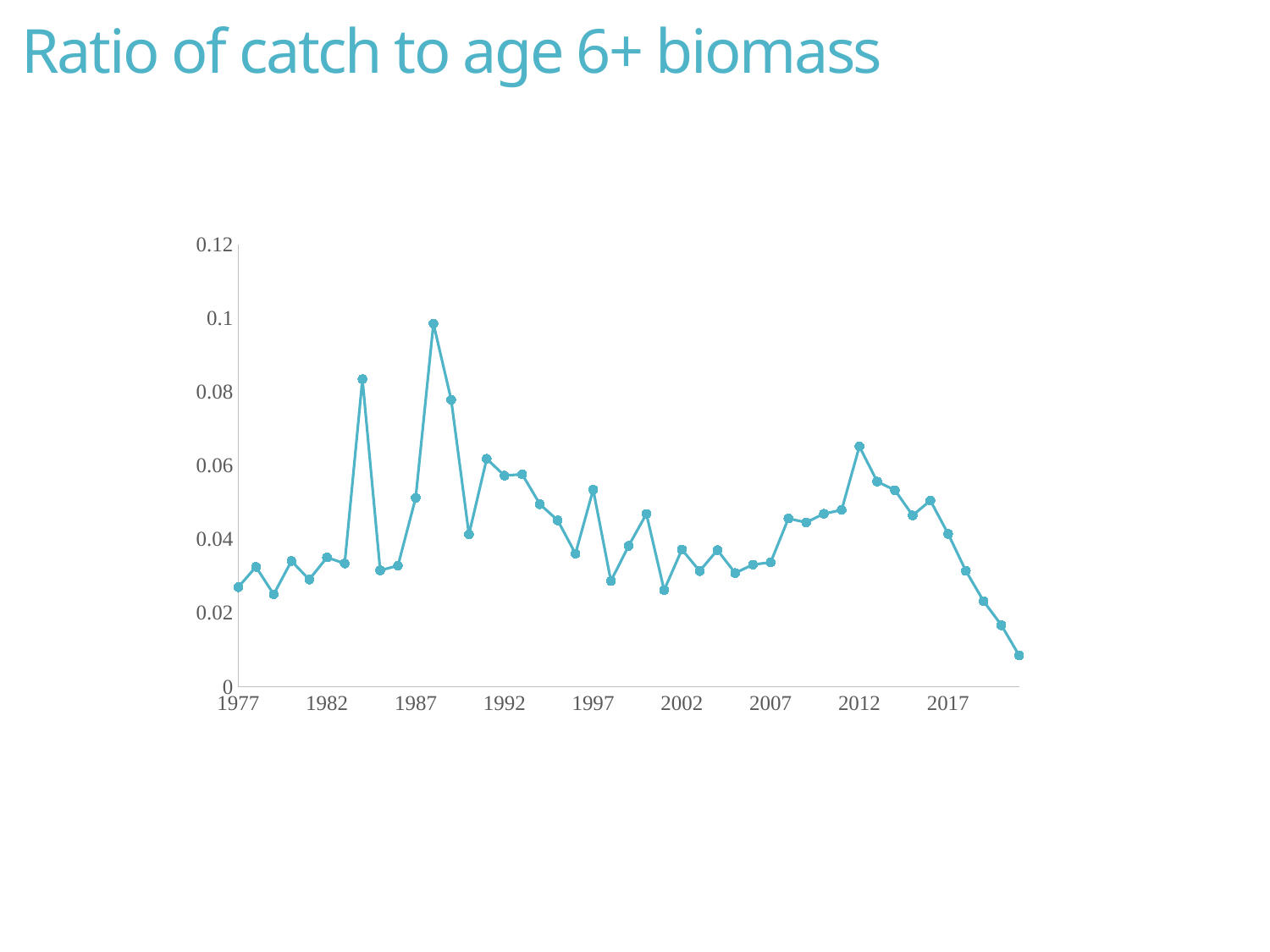
Is the value for 1977 greater or less than 0.04? less Is the value for 1987 greater or less than 0.04? greater Is the value for 1992 greater or less than 0.04? greater Which year has the larger value, 2007 or 2012? 2012 Which year has the larger value, 1977 or 1987? 1987 What kind of chart is shown on the slide? line chart What is the title of the chart? Ratio of catch to age 6+ biomass How many data series are plotted on the chart? 1 From 2012 to the end of the series, do the values generally rise or fall? fall